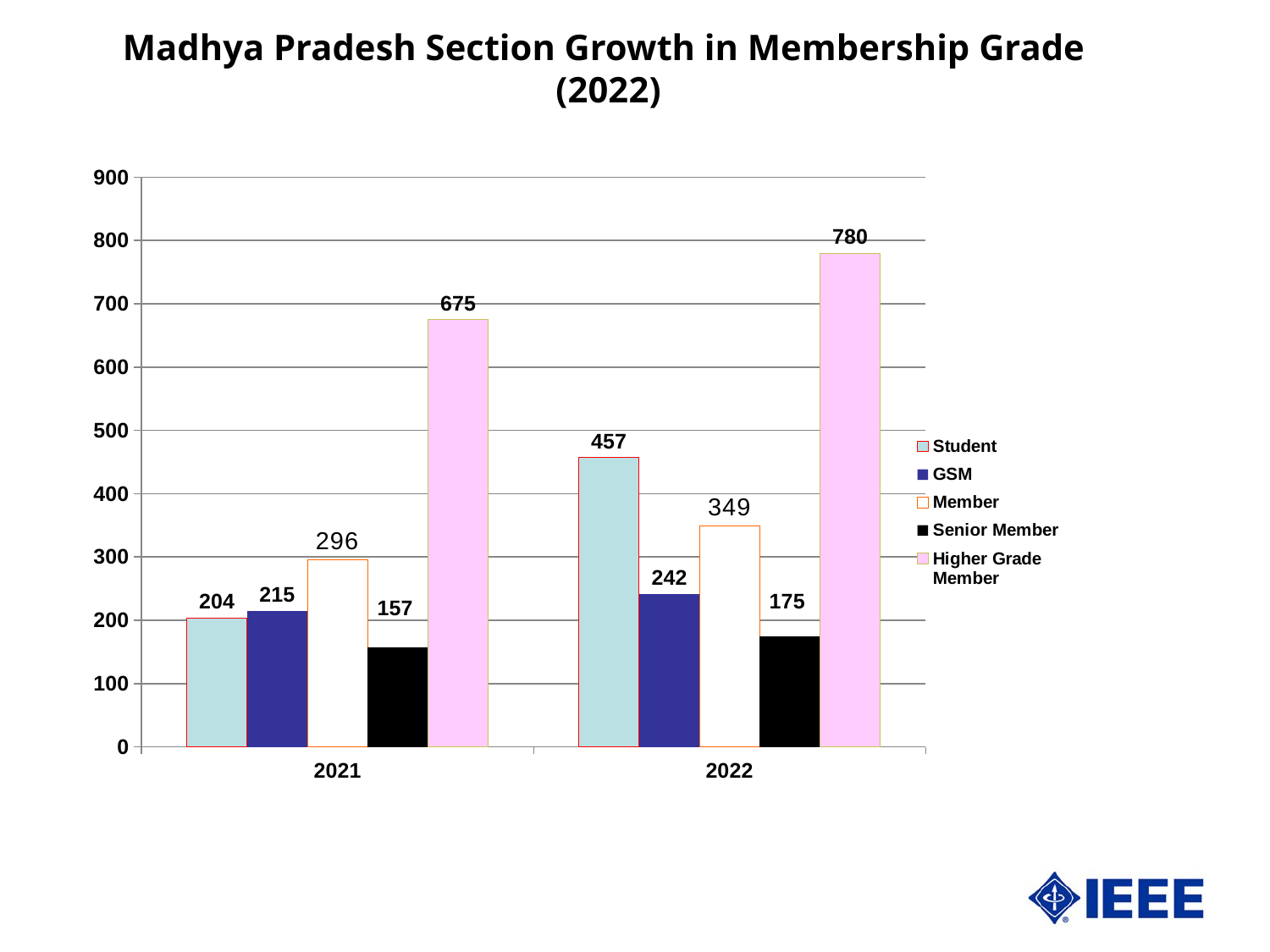
How many series does the legend list? 5 Which series has the lowest value in 2022? Senior Member What is the value for Student in 2021? 204 Does the Member value rise or fall from 2021 to 2022? Rise Which is larger, GSM in 2021 or Senior Member in 2022? GSM in 2021 What is the value for Member in 2022? 349 What is the difference between the Higher Grade Member values for 2022 and 2021? 105 What is the value for Higher Grade Member in 2022? 780 What kind of chart is shown on the slide? Bar chart How many year categories are shown on the x axis? 2 Which series has the highest value in 2021? Higher Grade Member What is the difference between the Student values for 2022 and 2021? 253